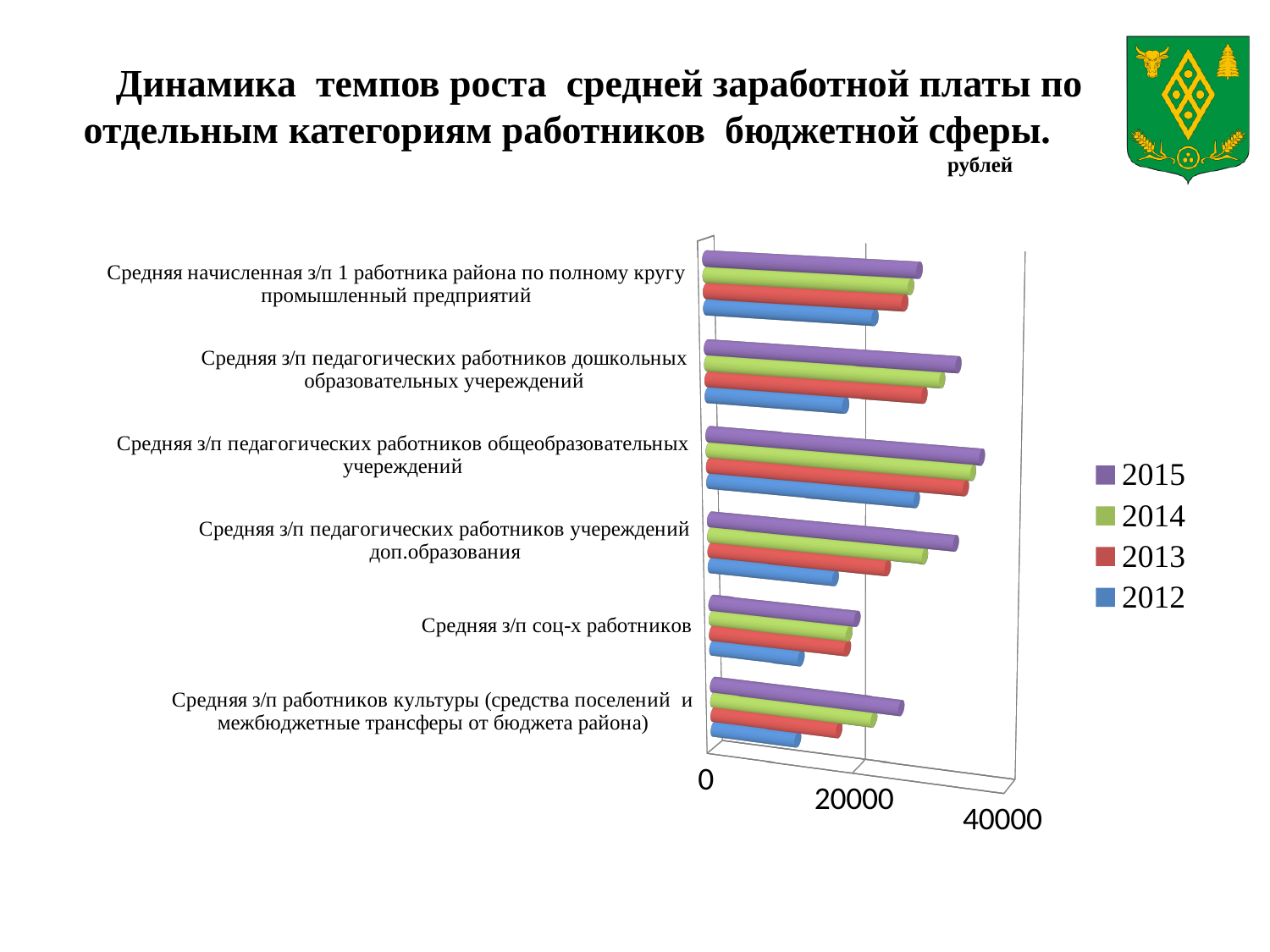
Is the 2015 value for 'Средняя з/п педагогических работников дошкольных образовательных учереждений' greater or less than 20000? greater For 'Средняя з/п соц-х работников', which is larger: the 2015 value or the 2012 value? 2015 Which is larger for 2012: 'Средняя з/п педагогических работников общеобразовательных учереждений' or 'Средняя з/п работников культуры (средства поселений и межбюджетные трансферы от бюджета района)'? Средняя з/п педагогических работников общеобразовательных учереждений How many categories of workers are plotted on the chart? 6 What unit is indicated for the values on the chart? рублей Which years are listed in the chart legend? 2015, 2014, 2013, 2012 Which category has the lowest 2015 value? Средняя з/п соц-х работников How many series does the legend list? 4 What kind of chart is shown on the slide? bar chart Is the 2012 value for 'Средняя з/п работников культуры (средства поселений и межбюджетные трансферы от бюджета района)' greater or less than 20000? less Is the 2012 value for 'Средняя з/п соц-х работников' greater or less than 20000? less